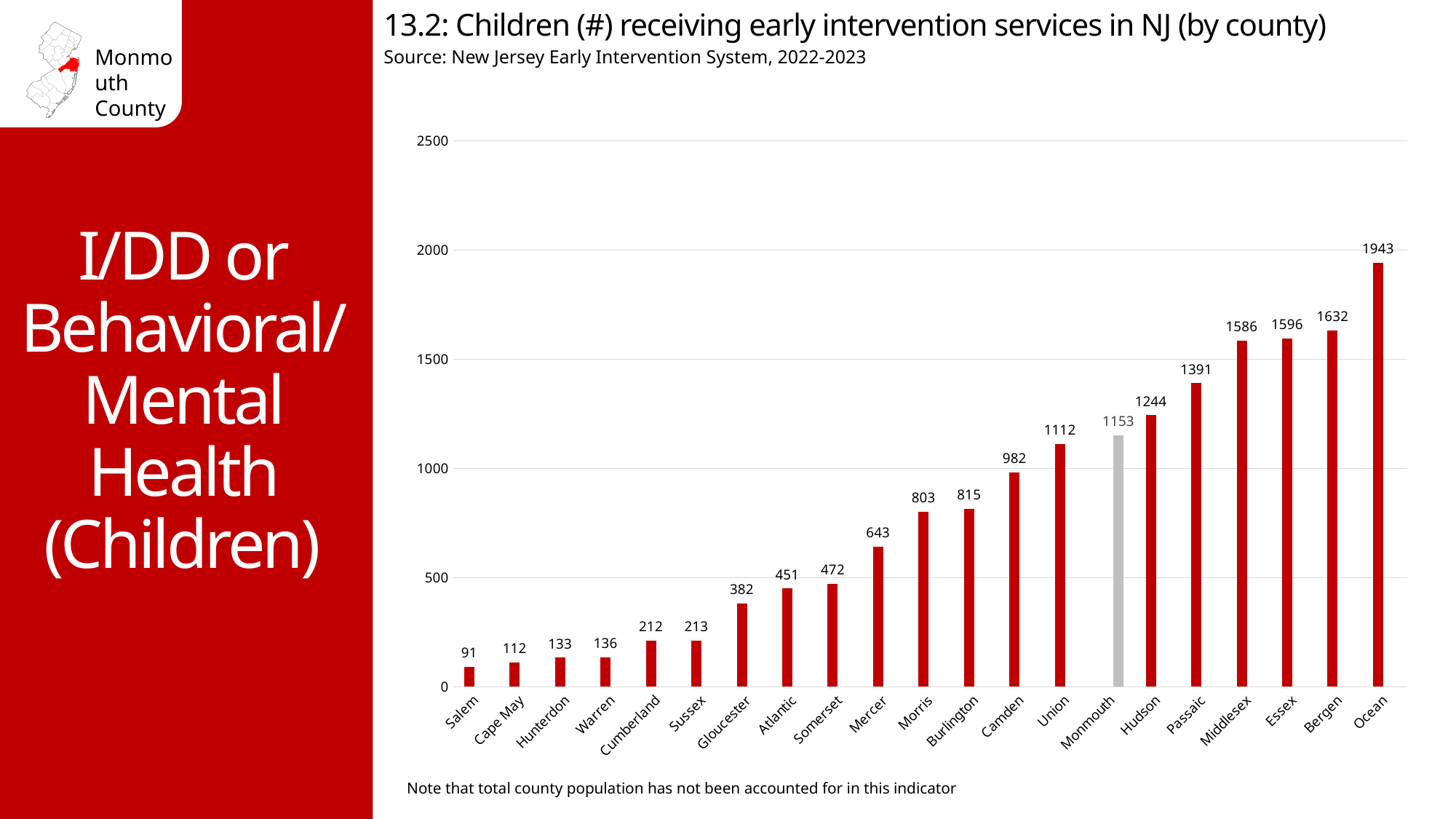
What kind of chart is shown on the slide? Bar chart Which county has the lowest number of children receiving early intervention services? Salem What is the difference between the values for Bergen and Essex? 36 What is the value shown for Ocean County? 1943 Which county has the highest number of children receiving early intervention services? Ocean What is the difference between the values for Ocean and Monmouth? 790 How many children are receiving early intervention services in Monmouth County? 1153 How many counties are shown on the x axis? 21 What is the value shown for Salem County? 91 Which county has a larger value, Hudson or Union? Hudson Which county's bar is shown in grey rather than red? Monmouth Is the value for Camden greater or less than 1000? less